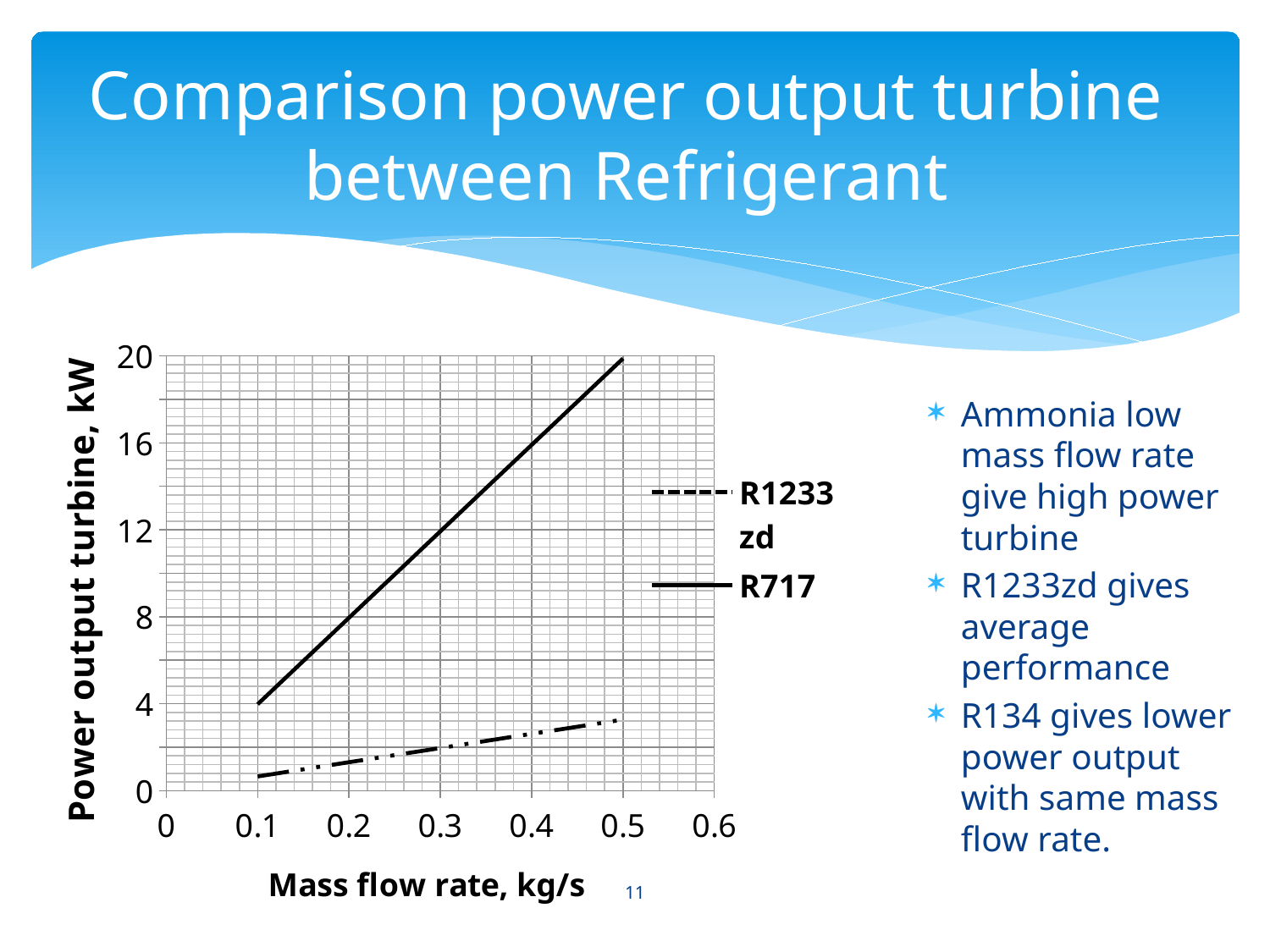
Does the power output for R717 rise or fall as the mass flow rate increases? rise Is the power output for R1233zd at a mass flow rate of 0.1 kg/s greater or less than 4 kW? less Which series is drawn with a dashed line in the chart? R1233zd Which series has the higher power output at a mass flow rate of 0.3 kg/s, R717 or R1233zd? R717 Which series has the lowest power output across the plotted range? R1233zd Does the power output for R1233zd rise or fall as the mass flow rate increases? rise Is the power output for R1233zd at a mass flow rate of 0.5 kg/s greater or less than 4 kW? less What is the label of the chart's x axis? Mass flow rate, kg/s How many series does the chart's legend list? 2 Is the power output for R717 at a mass flow rate of 0.5 kg/s greater or less than 16 kW? greater Which series reaches the highest power output on the chart? R717 What kind of chart is shown on the slide? line chart